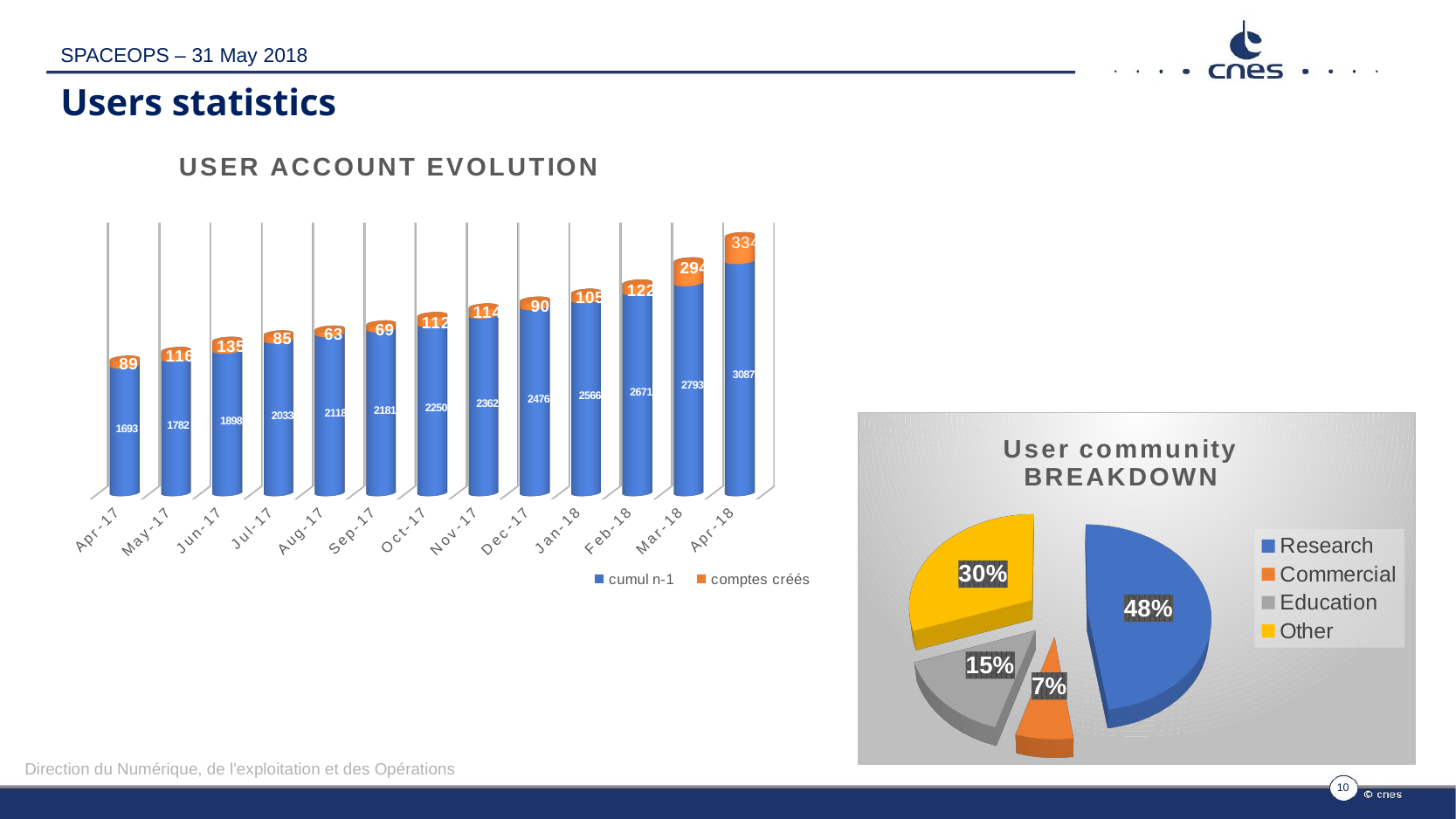
In the User community BREAKDOWN pie chart, which category has the smallest slice? Commercial In the USER ACCOUNT EVOLUTION chart, what is the total of the stacked bar for Apr-18? 3421 In the USER ACCOUNT EVOLUTION chart, what is the cumul n-1 value for Apr-18? 3087 In the USER ACCOUNT EVOLUTION chart, does the cumul n-1 value rise or fall from Apr-17 to Apr-18? Rise In the USER ACCOUNT EVOLUTION chart, which month has the lowest comptes créés value? Aug-17 How many months are shown on the x axis of the USER ACCOUNT EVOLUTION chart? 13 In the USER ACCOUNT EVOLUTION chart, what is the difference between the cumul n-1 values for Apr-18 and Apr-17? 1394 What kind of chart is the USER ACCOUNT EVOLUTION chart? Stacked bar chart In the User community BREAKDOWN pie chart, what share does Research have? 48% In the USER ACCOUNT EVOLUTION chart, which month has the highest comptes créés value? Apr-18 In the USER ACCOUNT EVOLUTION chart, what is the comptes créés value for Mar-18? 294 How many series does the legend of the USER ACCOUNT EVOLUTION chart list? 2